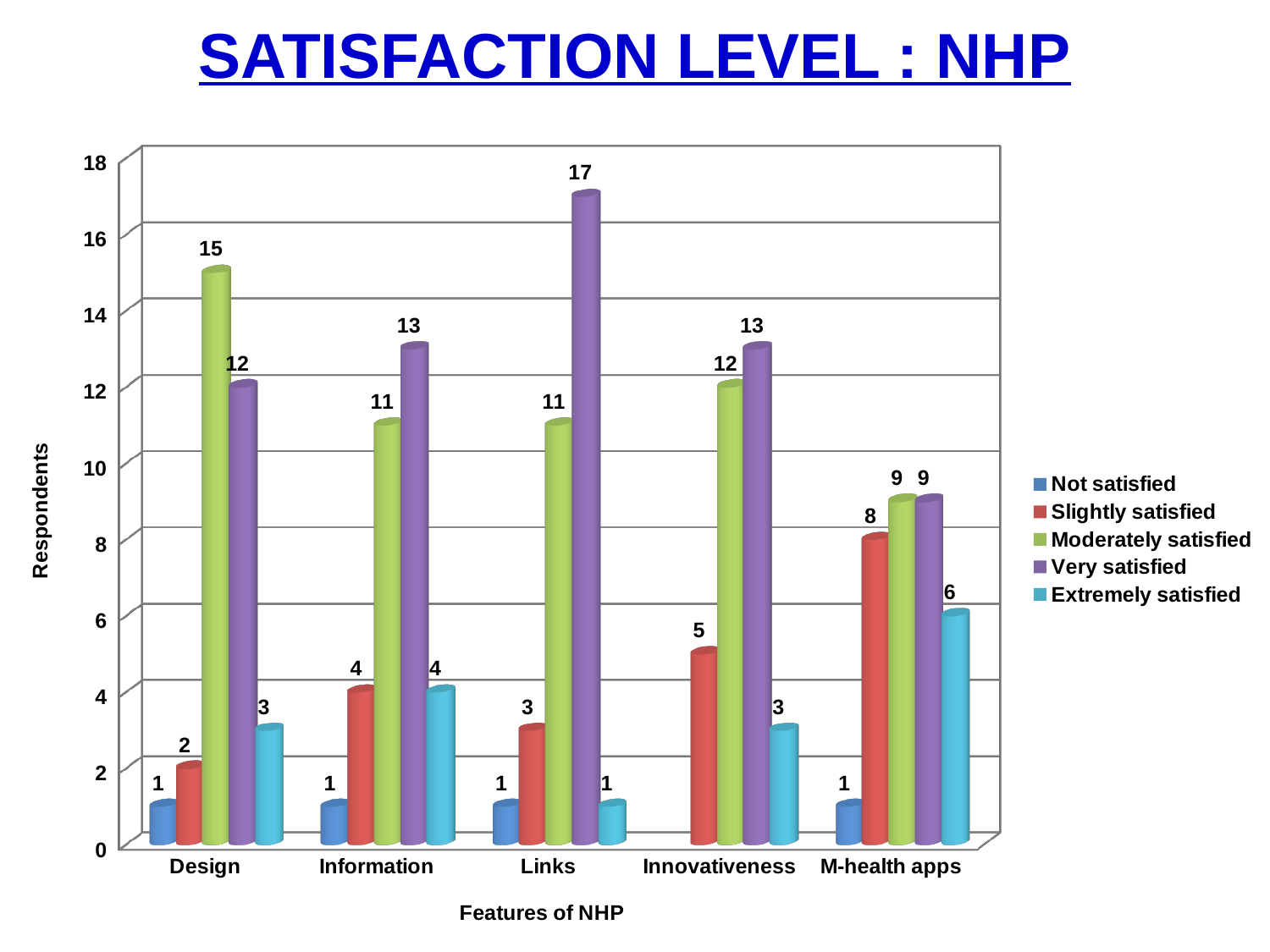
What is the difference between the Very satisfied values for Links and Design? 5 How many features of NHP are shown on the x axis? 5 How many respondents were Extremely satisfied with Information? 4 How many respondents were Very satisfied with Links? 17 Which feature has the highest Very satisfied value? Links Which feature has the lowest Moderately satisfied value? M-health apps How many respondents were Moderately satisfied with Design? 15 How many series does the legend list? 5 Which is larger: the Slightly satisfied value for Innovativeness or for Information? Innovativeness What type of chart is shown on the slide? bar chart How many respondents were Slightly satisfied with M-health apps? 8 What is the title of the chart's y axis? Respondents